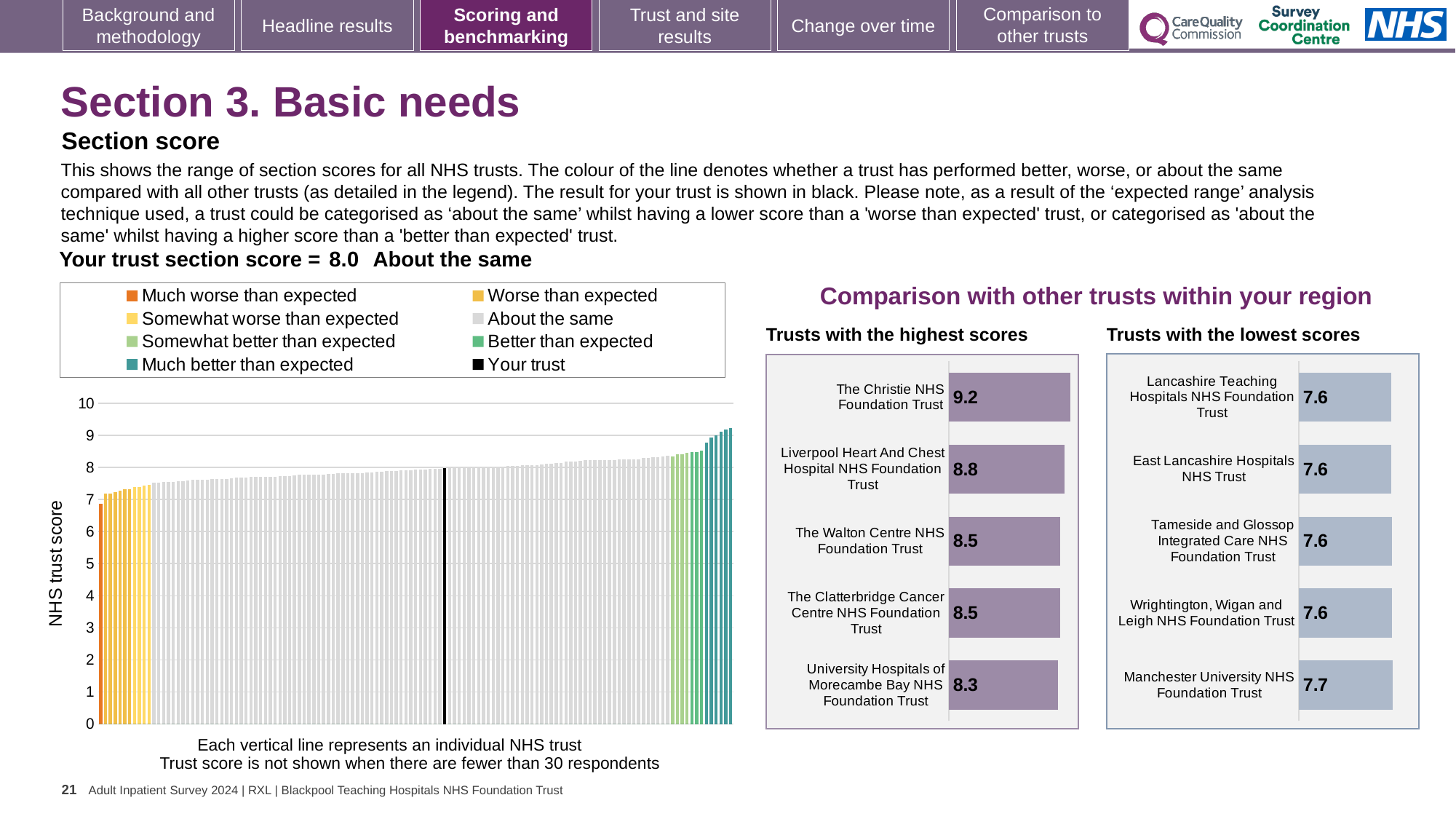
On the main chart of NHS trust scores, what is the section score for your trust? 8.0 In the 'Trusts with the highest scores' chart, how many trusts are shown? 5 On the main chart of NHS trust scores, is the value for the highest-scoring trust greater or less than 9? greater In the 'Trusts with the highest scores' chart, which trust has the lowest score? University Hospitals of Morecambe Bay NHS Foundation Trust In the 'Trusts with the highest scores' chart, what is the difference between the scores of The Christie NHS Foundation Trust and University Hospitals of Morecambe Bay NHS Foundation Trust? 0.9 In the 'Trusts with the lowest scores' chart, what is the score for East Lancashire Hospitals NHS Trust? 7.6 What kind of chart is the main chart of NHS trust scores? bar chart On the main chart of NHS trust scores, is the value for the lowest-scoring trust (the orange bar) greater or less than 7? less In the 'Trusts with the lowest scores' chart, which trust has the highest score? Manchester University NHS Foundation Trust On the main chart of NHS trust scores, how many entries does the legend list? 8 On the main chart of NHS trust scores, what is the label on the vertical axis? NHS trust score In the 'Trusts with the highest scores' chart, what is the score for The Christie NHS Foundation Trust? 9.2